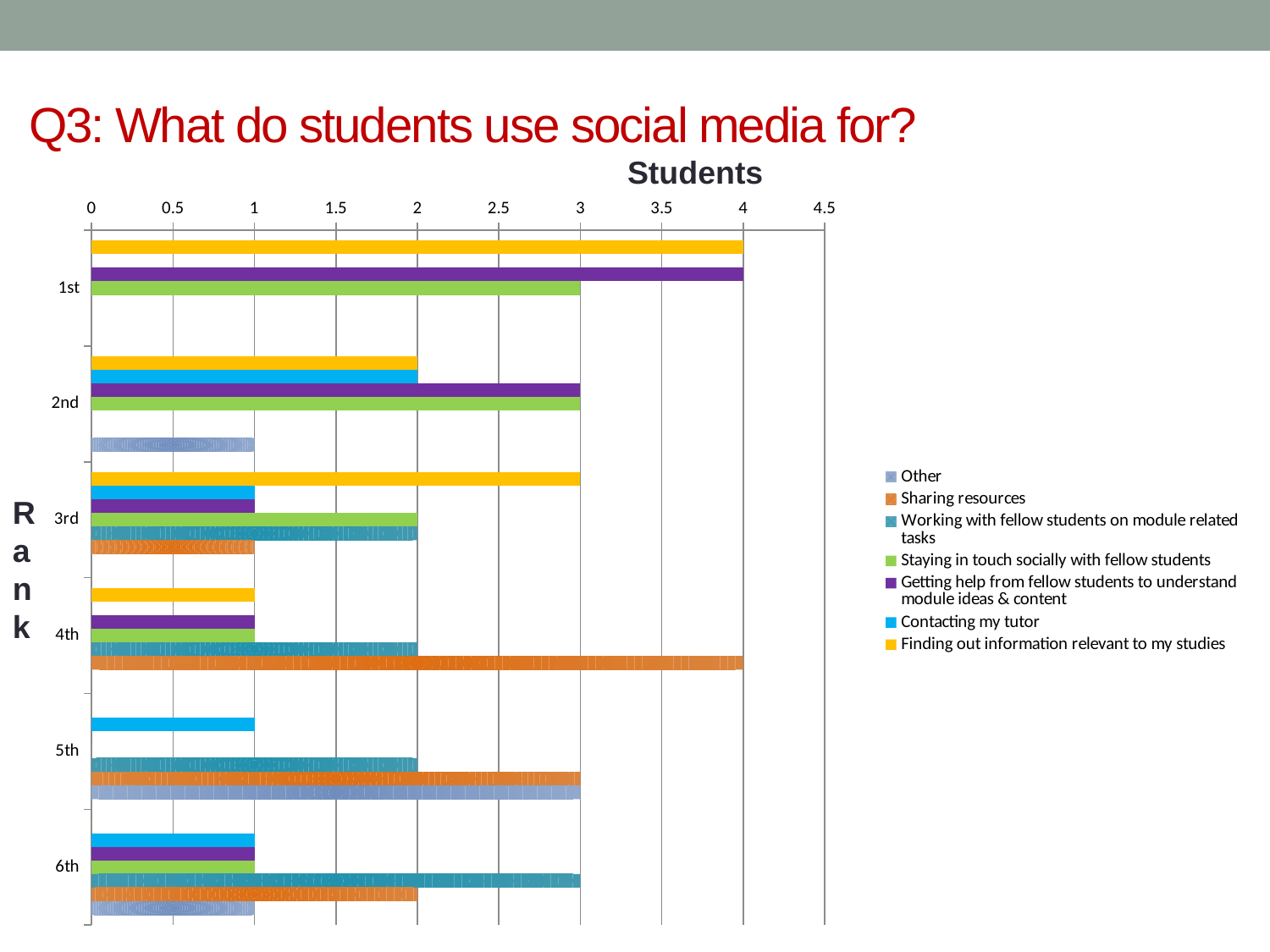
How many series does the legend list? 7 How many rank categories are shown on the vertical axis? 6 How many students ranked 'Sharing resources' 4th? 4 What is the title of the chart? Students How many students ranked 'Working with fellow students on module related tasks' 6th? 3 What kind of chart is shown on the slide? bar chart What is the difference between the 'Getting help from fellow students to understand module ideas & content' value for 1st and for 3rd? 3 What is the value for 'Other' in the 5th rank group? 3 Which series has the longest bar in the 3rd rank group? Finding out information relevant to my studies How many students ranked 'Staying in touch socially with fellow students' 2nd? 3 In the 5th rank group, which is larger: 'Sharing resources' or 'Working with fellow students on module related tasks'? Sharing resources How many students ranked 'Finding out information relevant to my studies' 1st? 4